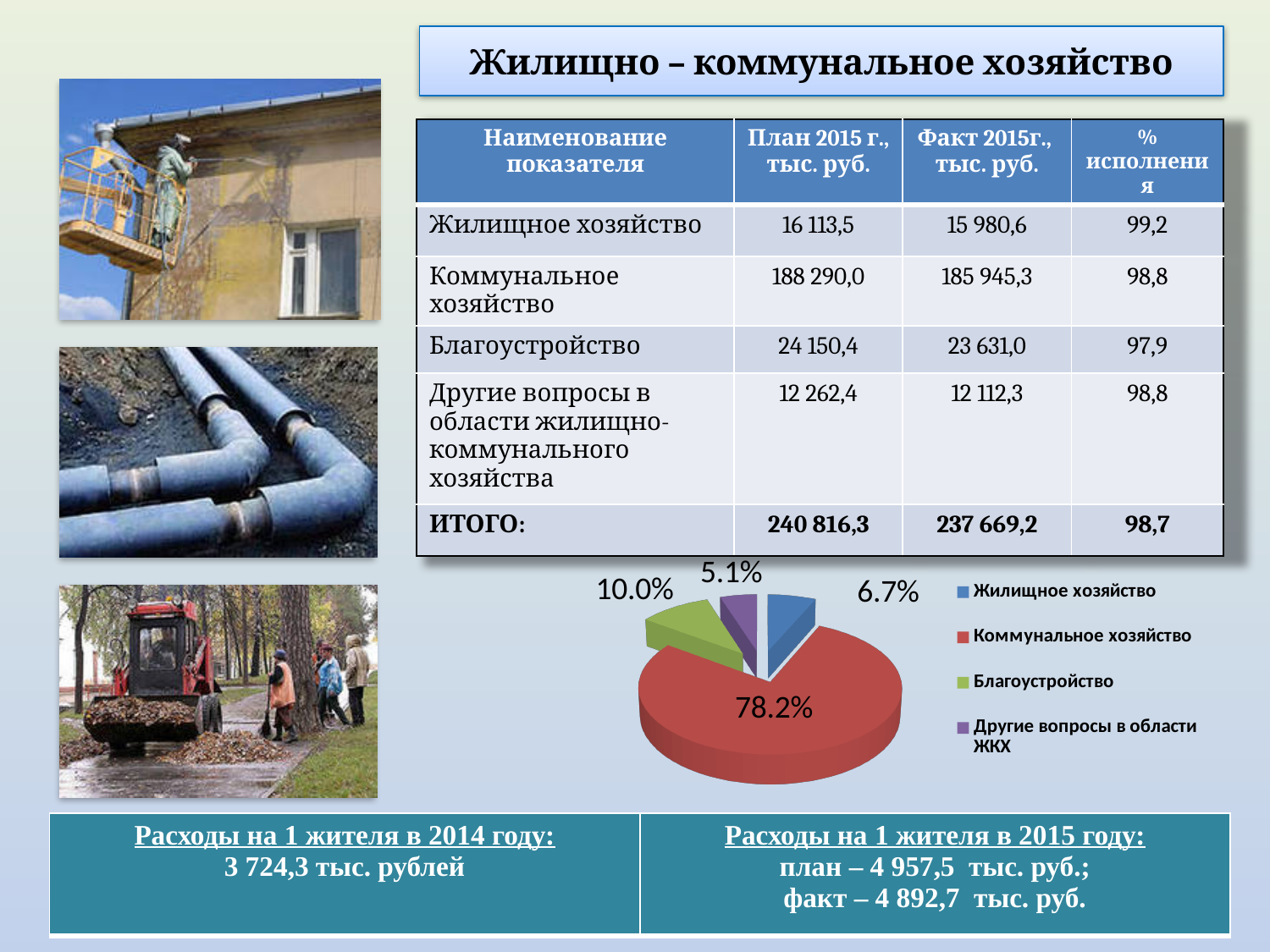
How many entries does the pie chart legend list? 4 In the pie chart, what share does Коммунальное хозяйство have? 78.2% Which category has the smallest slice in the pie chart? Другие вопросы в области ЖКХ What kind of chart is shown on the slide? pie chart How many slices does the pie chart have? 4 What colour is the Коммунальное хозяйство slice in the pie chart? red In the pie chart, what share does Другие вопросы в области ЖКХ have? 5.1% In the pie chart, what share does Жилищное хозяйство have? 6.7% Which category has the largest slice in the pie chart? Коммунальное хозяйство In the pie chart, what is the difference in percentage points between Коммунальное хозяйство and Благоустройство? 68.2 In the pie chart, what share does Благоустройство have? 10.0% In the pie chart, which is larger: Благоустройство or Жилищное хозяйство? Благоустройство